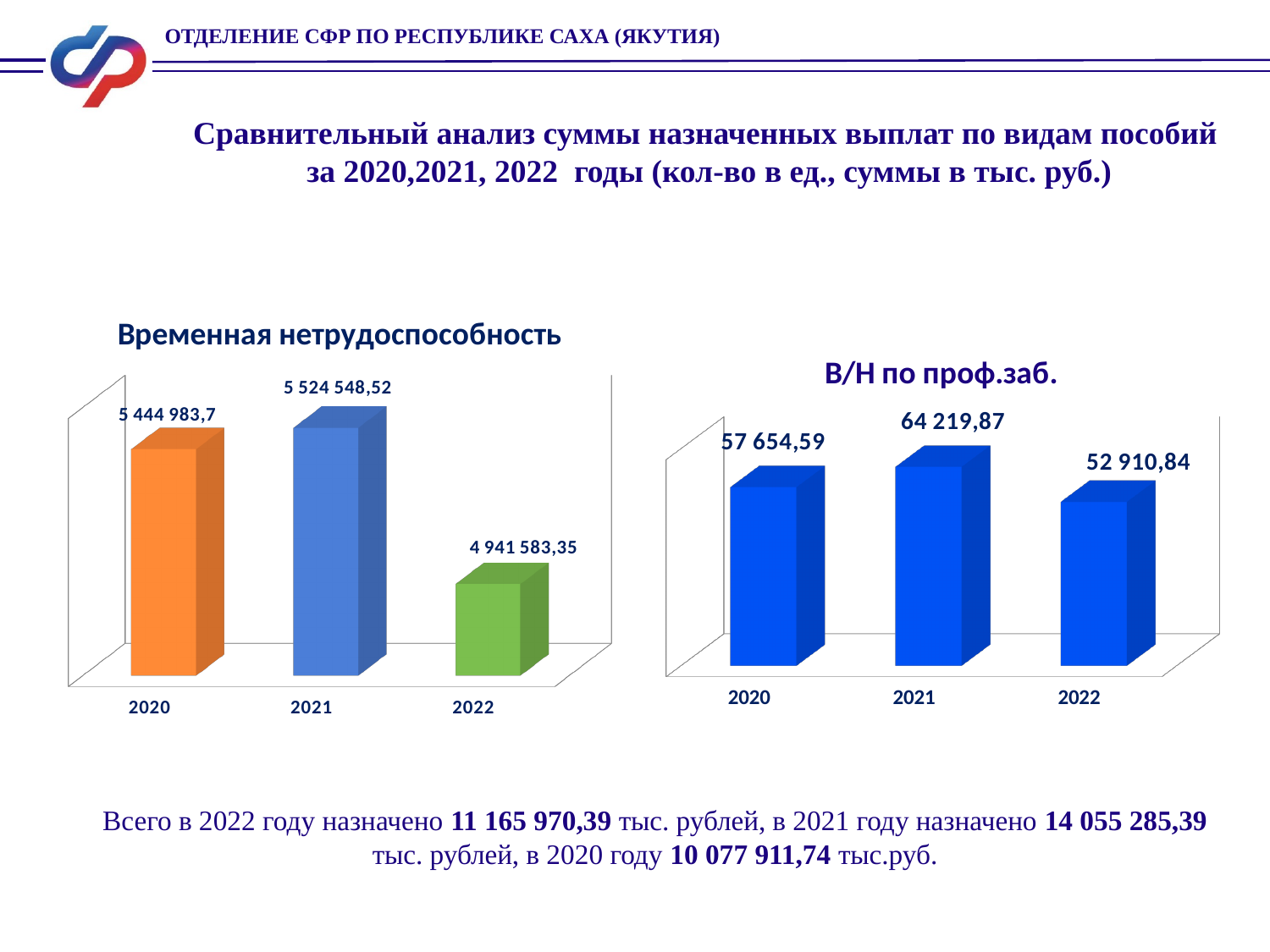
In the chart titled 'В/Н по проф.заб.', which year has the highest value? 2021 In the chart titled 'В/Н по проф.заб.', what is the value for 2022? 52 910,84 In the chart titled 'Временная нетрудоспособность', what is the difference between the 2021 and 2020 values? 79 564,82 In the chart titled 'В/Н по проф.заб.', what is the difference between the 2021 and 2022 values? 11 309,03 In the chart titled 'В/Н по проф.заб.', what is the value for 2020? 57 654,59 In the chart titled 'Временная нетрудоспособность', what is the value for 2022? 4 941 583,35 In the chart titled 'В/Н по проф.заб.', which is larger, the value for 2020 or the value for 2022? 2020 In the chart titled 'В/Н по проф.заб.', which year has the lowest value? 2022 In the chart titled 'Временная нетрудоспособность', which year has the highest value? 2021 How many years are shown in the chart titled 'Временная нетрудоспособность'? 3 In the chart titled 'Временная нетрудоспособность', which year has the lowest value? 2022 In the chart titled 'Временная нетрудоспособность', what is the value for 2021? 5 524 548,52